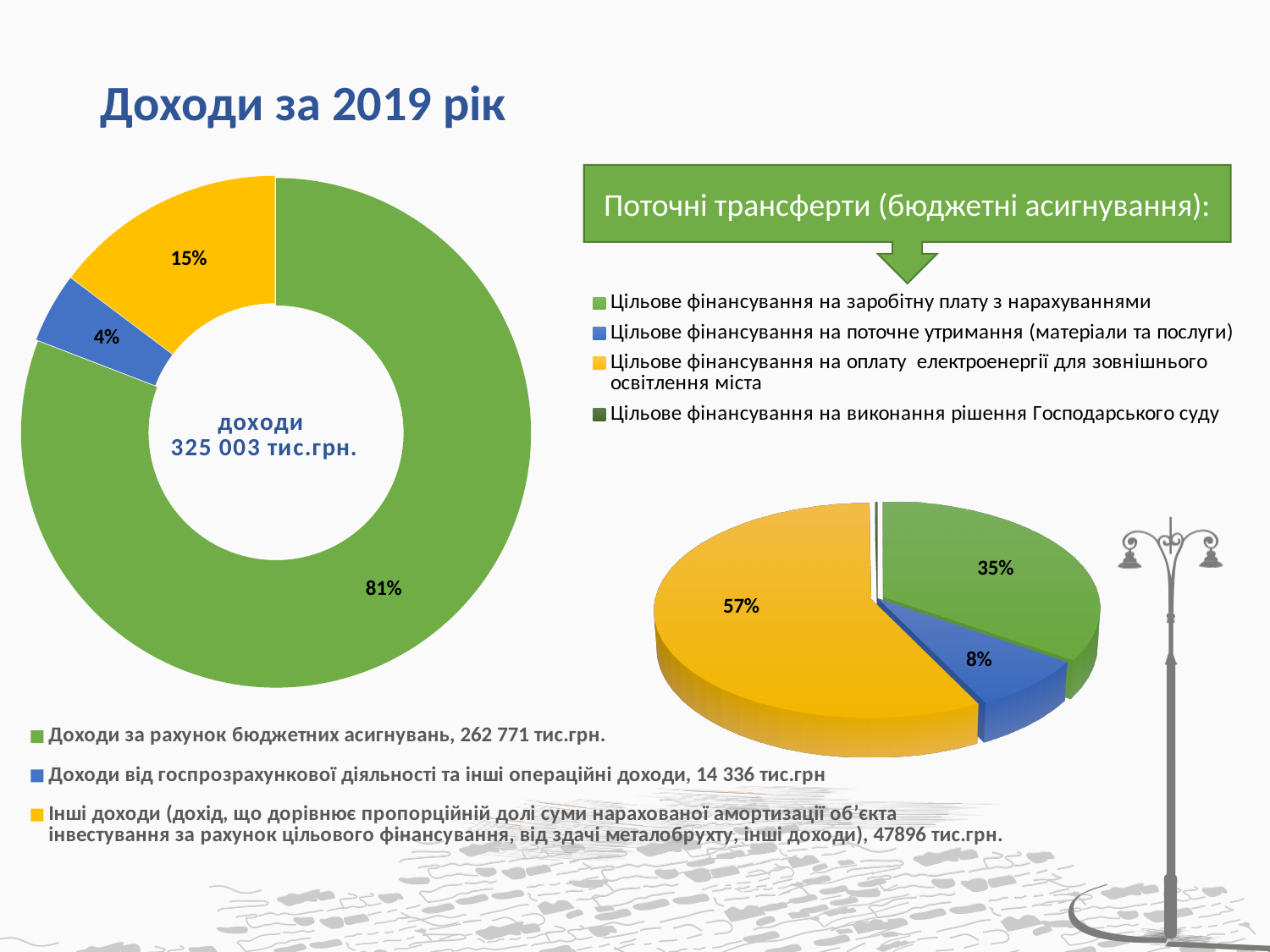
In the doughnut chart on the left, what share is shown for 'Доходи від госпрозрахункової діяльності та інші операційні доходи'? 4% In the doughnut chart on the left, what total income is printed in the centre? 325 003 тис.грн. In the pie chart on the right (Поточні трансферти), what is the difference in percentage points between the electricity share and the salary share? 22 percentage points In the pie chart on the right (Поточні трансферти), which category has the largest share? Цільове фінансування на оплату електроенергії для зовнішнього освітлення міста In the pie chart on the right (Поточні трансферти), what share is shown for 'Цільове фінансування на заробітну плату з нарахуваннями'? 35% In the pie chart on the right (Поточні трансферти), what share is shown for 'Цільове фінансування на поточне утримання (матеріали та послуги)'? 8% In the doughnut chart on the left, what share is shown for 'Доходи за рахунок бюджетних асигнувань'? 81% In the pie chart on the right (Поточні трансферти), how many entries does the legend list? 4 In the doughnut chart on the left, how many slices are shown? 3 In the doughnut chart on the left, which category has the smallest share? Доходи від госпрозрахункової діяльності та інші операційні доходи In the pie chart on the right (Поточні трансферти), what share is shown for 'Цільове фінансування на оплату електроенергії для зовнішнього освітлення міста'? 57% In the doughnut chart on the left, what share is shown for 'Інші доходи'? 15%